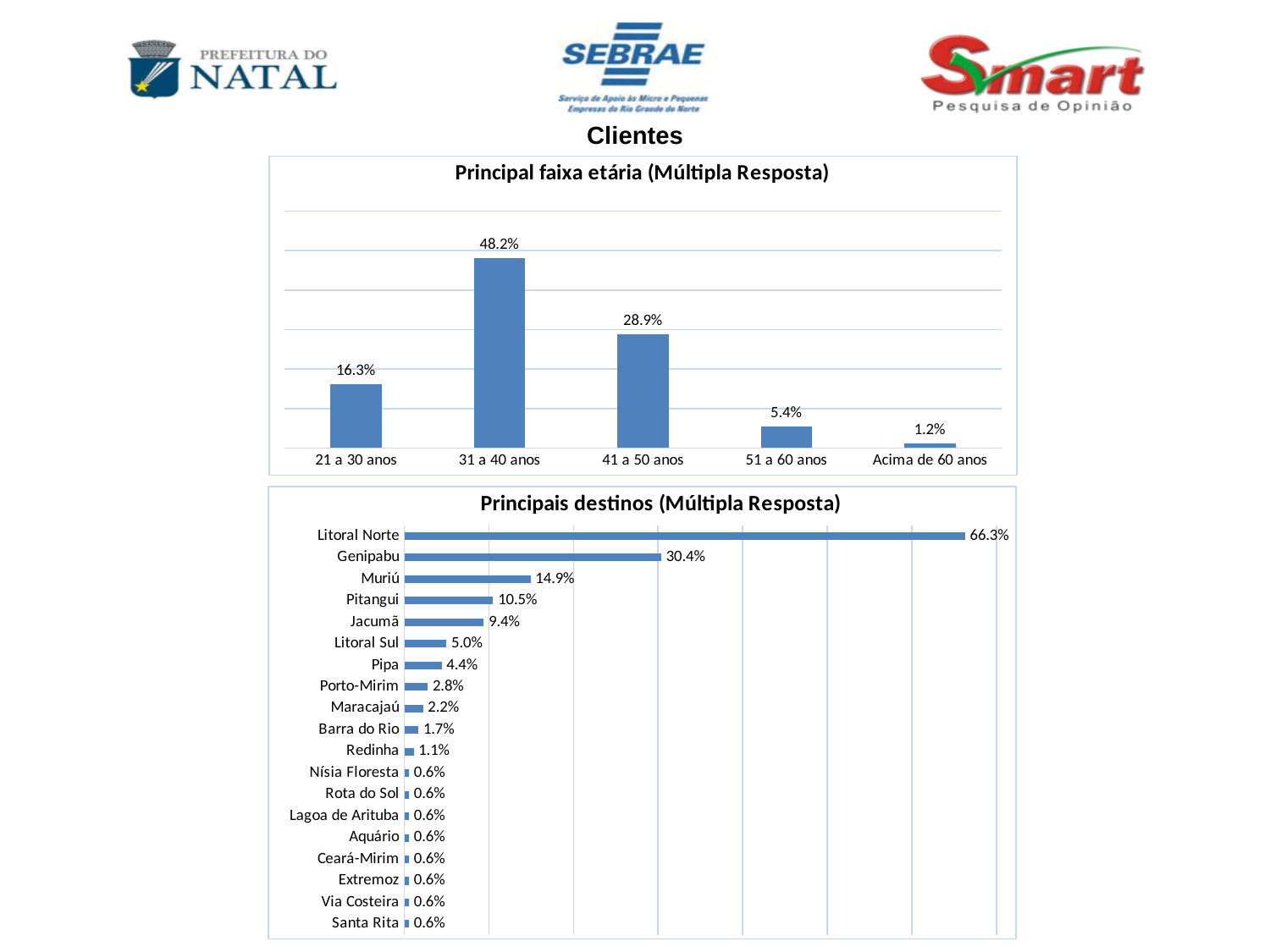
In the 'Principais destinos (Múltipla Resposta)' chart, what is the value for Genipabu? 30.4% In the 'Principais destinos (Múltipla Resposta)' chart, which destination has the highest value? Litoral Norte What type of chart is the 'Principais destinos (Múltipla Resposta)' chart? Bar chart In the 'Principais destinos (Múltipla Resposta)' chart, what is the difference between Litoral Norte and Genipabu? 35.9% In the 'Principal faixa etária (Múltipla Resposta)' chart, what is the value for 31 a 40 anos? 48.2% In the 'Principal faixa etária (Múltipla Resposta)' chart, what is the difference between 31 a 40 anos and 41 a 50 anos? 19.3% In the 'Principal faixa etária (Múltipla Resposta)' chart, which is larger: 21 a 30 anos or 51 a 60 anos? 21 a 30 anos In the 'Principais destinos (Múltipla Resposta)' chart, how many destinations are listed? 19 In the 'Principais destinos (Múltipla Resposta)' chart, what is the value for Pipa? 4.4% In the 'Principal faixa etária (Múltipla Resposta)' chart, which age group has the lowest value? Acima de 60 anos In the 'Principal faixa etária (Múltipla Resposta)' chart, how many age groups are shown? 5 What is the title of the top chart on the slide? Principal faixa etária (Múltipla Resposta)